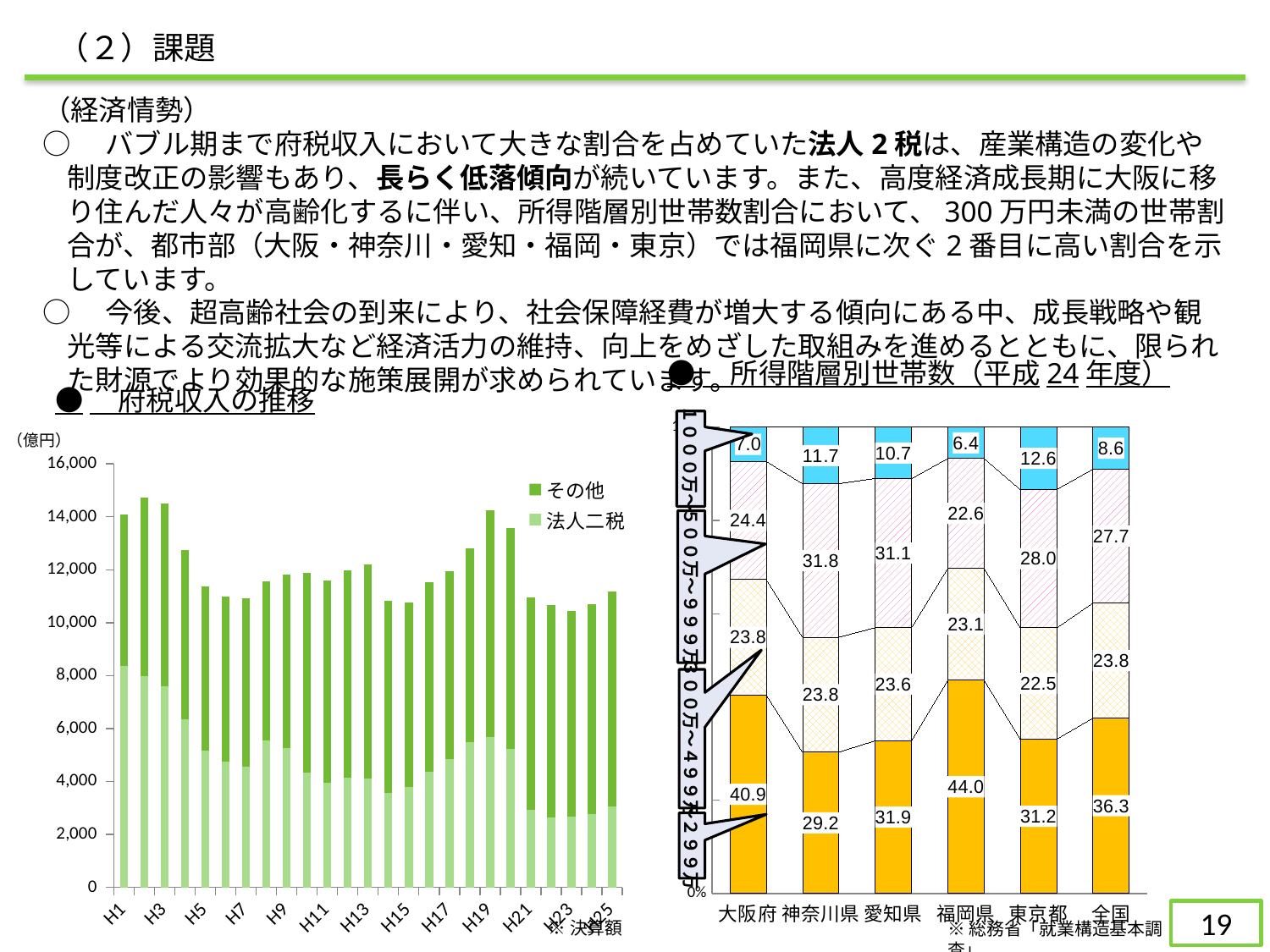
How many series does the legend of the left chart (府税収入の推移) list? 2 In the right chart (所得階層別世帯数), which has the larger top (blue) segment value, 東京都 or 神奈川県? 東京都 What kind of chart is the left chart titled 府税収入の推移? bar chart In the left chart (府税収入の推移), is the total bar for H2 greater or less than 14,000? greater In the right chart (所得階層別世帯数), which category has the lowest top (blue) segment value? 福岡県 In the left chart (府税収入の推移), does the 法人二税 segment generally rise or fall from H1 to H25? fall What are the two legend entries of the left chart (府税収入の推移)? その他, 法人二税 In the right chart (所得階層別世帯数), which category has the highest bottom (orange) segment value? 福岡県 In the right chart (所得階層別世帯数), what is the difference between the bottom (orange) segment values of 福岡県 and 大阪府? 3.1 In the right chart (所得階層別世帯数), what is the value of the bottom (orange) segment for 大阪府? 40.9 How many prefecture/region categories are shown on the x axis of the right chart (所得階層別世帯数)? 6 In the left chart (府税収入の推移), is the total bar for H15 greater or less than 12,000? less